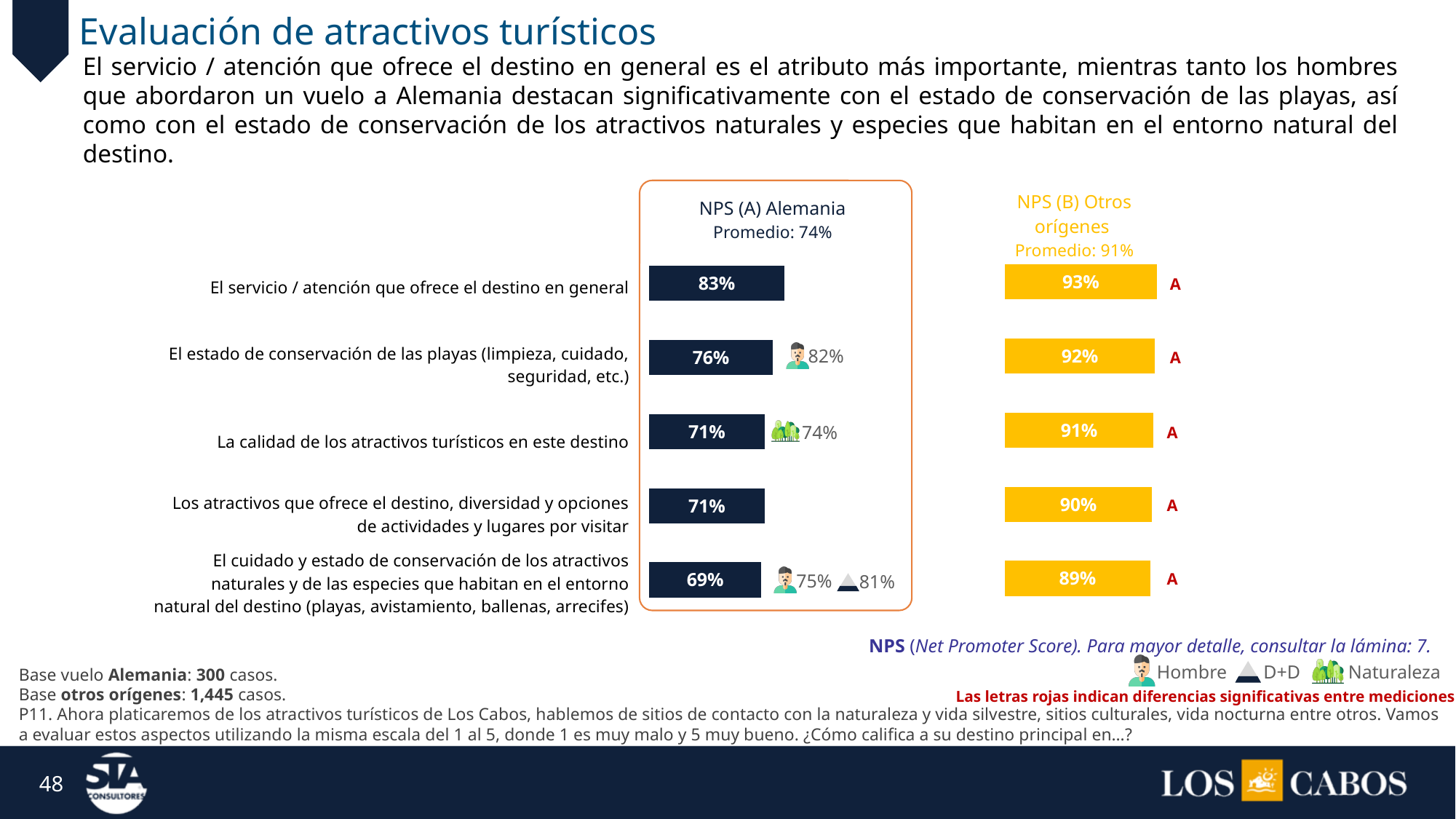
What is the average (Promedio) shown for NPS (A) Alemania? 74% What is the average (Promedio) shown for NPS (B) Otros orígenes? 91% How many categories are shown in the NPS (A) Alemania chart? 5 In the NPS (B) Otros orígenes chart, which category has the highest value? El servicio / atención que ofrece el destino en general In the NPS (B) Otros orígenes chart, what is the value for 'El cuidado y estado de conservación de los atractivos naturales y de las especies que habitan en el entorno natural del destino'? 89% In the NPS (A) Alemania chart, which category has the lowest value? El cuidado y estado de conservación de los atractivos naturales y de las especies que habitan en el entorno natural del destino What is the difference between the NPS (B) Otros orígenes value and the NPS (A) Alemania value for 'El estado de conservación de las playas'? 16% In the NPS (A) Alemania chart, what is the value for 'El servicio / atención que ofrece el destino en general'? 83% What type of chart is used for NPS (A) Alemania? Bar chart In the NPS (B) Otros orígenes chart, what is the value for 'La calidad de los atractivos turísticos en este destino'? 91% In the NPS (A) Alemania chart, what is the value for 'El cuidado y estado de conservación de los atractivos naturales y de las especies que habitan en el entorno natural del destino'? 69% For 'Los atractivos que ofrece el destino, diversidad y opciones de actividades y lugares por visitar', which is larger: the NPS (A) Alemania value or the NPS (B) Otros orígenes value? NPS (B) Otros orígenes